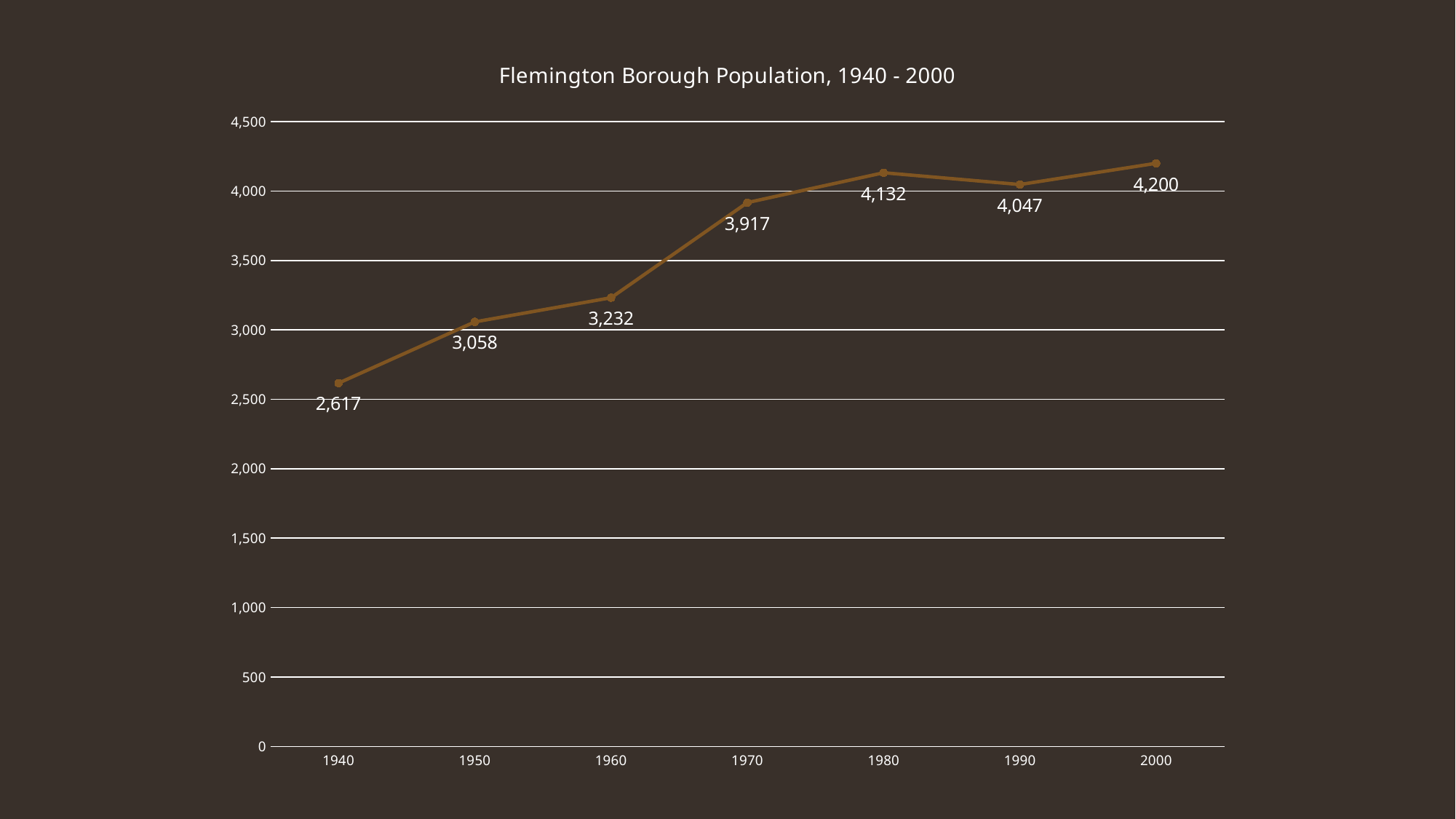
What was the population of Flemington Borough in 1940? 2,617 What is the difference in population between 1940 and 2000? 1,583 Which year has the highest population value on the chart? 2000 What is the title of the chart? Flemington Borough Population, 1940 - 2000 Is the value for 1950 greater or less than 3,000? greater What kind of chart is shown on the slide? Line chart Which year had a larger population, 1960 or 1970? 1970 What is the difference in population between 1980 and 1990? 85 What was the population of Flemington Borough in 1990? 4,047 How many data points are plotted on the chart? 7 What was the population of Flemington Borough in 1970? 3,917 Which year has the lowest population value on the chart? 1940